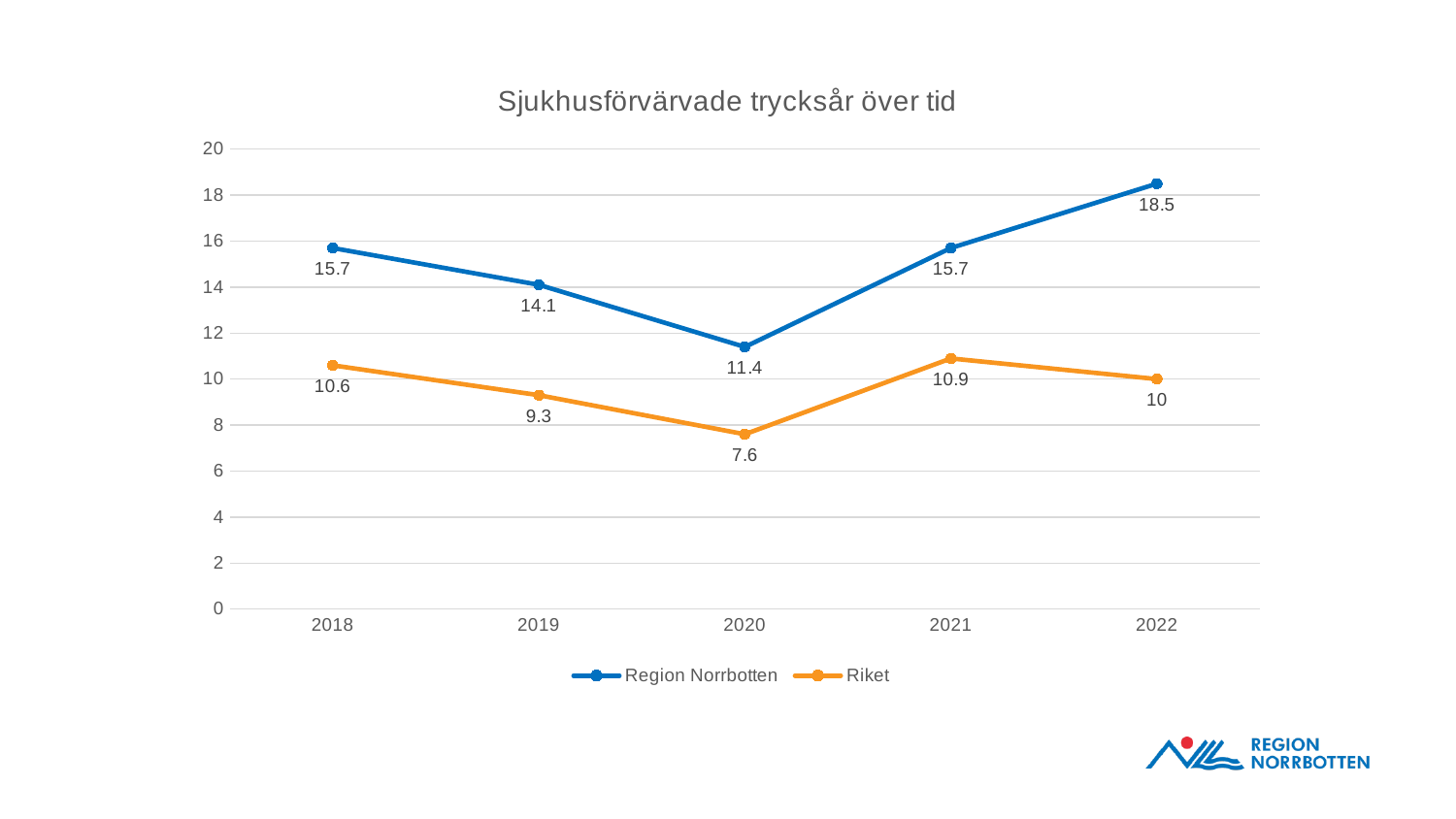
What is the difference between Region Norrbotten and Riket in 2022? 8.5 In which year is the Riket value highest? 2021 What is the difference between the Region Norrbotten values in 2021 and 2020? 4.3 What is the value for Riket in 2018? 10.6 What is the title of the chart? Sjukhusförvärvade trycksår över tid How many years are shown on the x axis? 5 How many series does the legend list? 2 What is the value for Region Norrbotten in 2022? 18.5 In which year is the Region Norrbotten value lowest? 2020 Which is larger in 2019, Region Norrbotten or Riket? Region Norrbotten What is the value for Riket in 2020? 7.6 What kind of chart is shown? Line chart